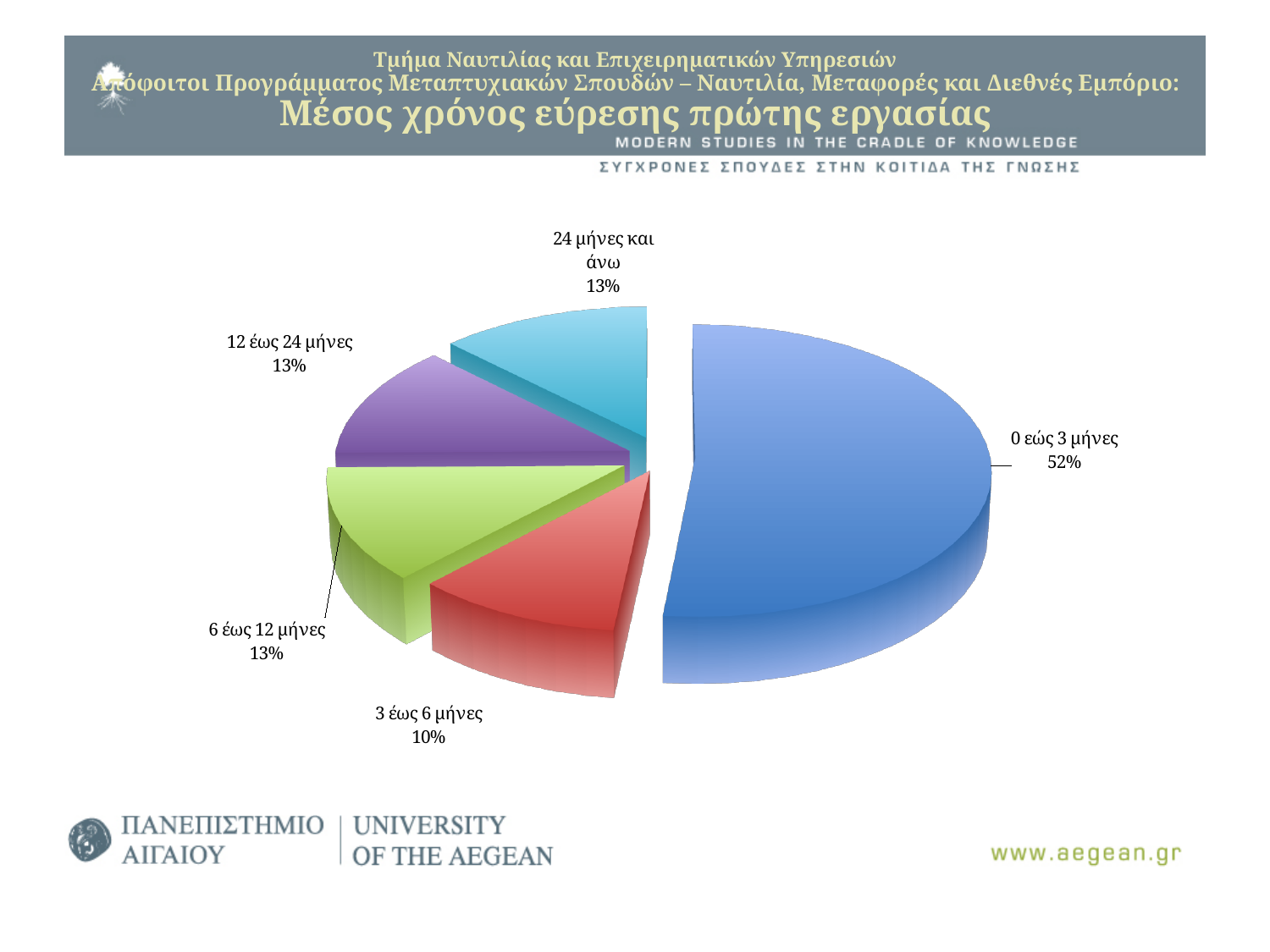
What is the value shown for '6 έως 12 μήνες'? 13% What type of chart is shown on the slide? Pie chart What is the difference in percentage points between '0 εώς 3 μήνες' and '3 έως 6 μήνες'? 42 How many slices does the pie chart have? 5 What share of the pie does the '0 εώς 3 μήνες' slice represent? 52% Which category has the largest share of the pie? 0 εώς 3 μήνες What is the value shown for '3 έως 6 μήνες'? 10% What is the value shown for '12 έως 24 μήνες'? 13% What is the title of the chart on the slide? Μέσος χρόνος εύρεσης πρώτης εργασίας What is the value shown for '24 μήνες και άνω'? 13% Which is larger, the share for '0 εώς 3 μήνες' or the share for '24 μήνες και άνω'? 0 εώς 3 μήνες Which category has the smallest share of the pie? 3 έως 6 μήνες